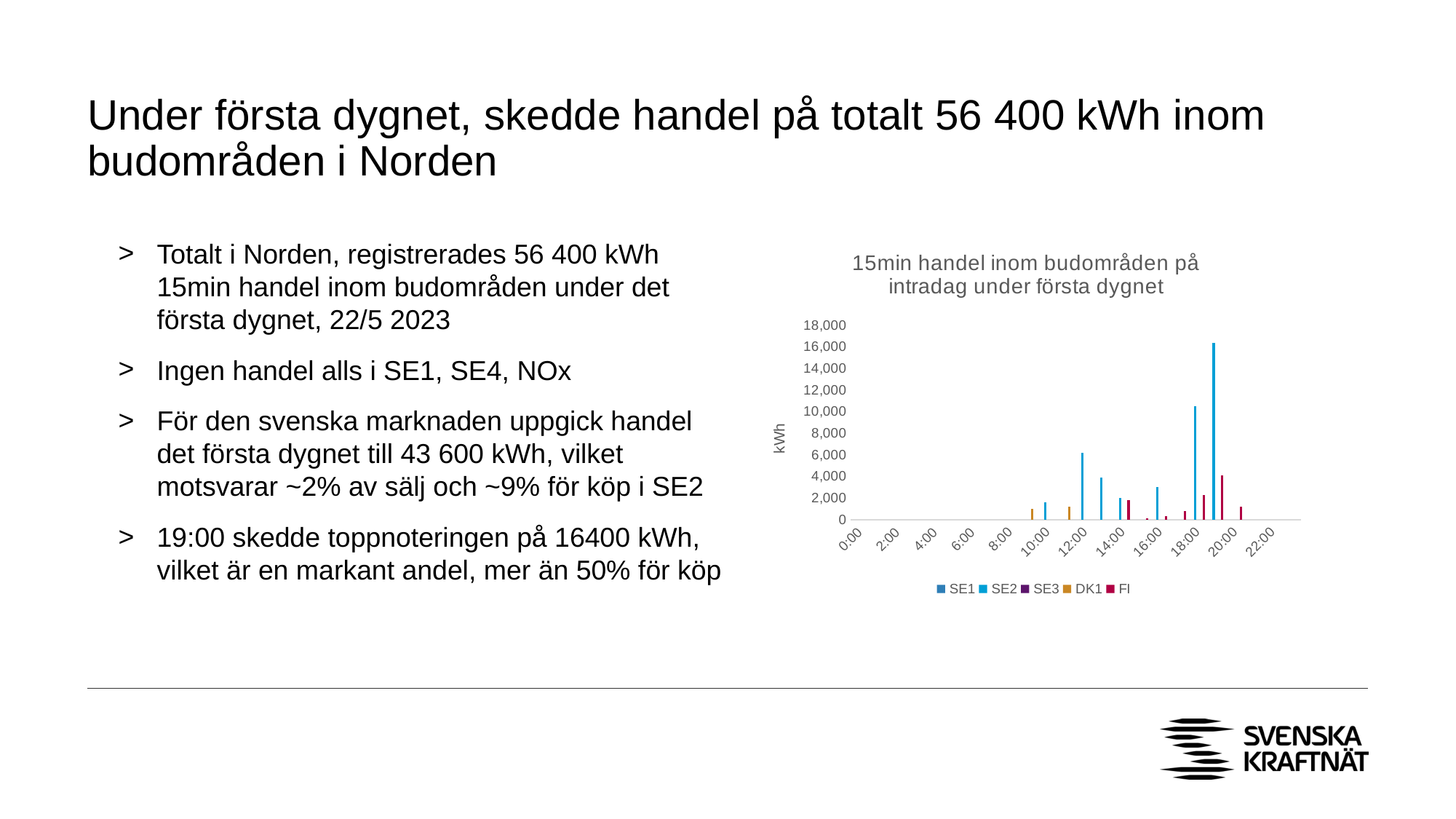
How many series does the chart legend list? 5 Which series has the tallest bar in the chart? SE2 What kind of chart is shown on the slide? bar chart What is the title of the chart? 15min handel inom budområden på intradag under första dygnet Which is larger, the tallest SE2 bar or the tallest FI bar? SE2 Is the tallest FI bar greater or less than 6,000? less Is the tallest SE2 bar (around 19:00) greater or less than 14,000? greater Which series are listed in the chart legend? SE1, SE2, SE3, DK1, FI Is the SE2 bar around 18:00 greater or less than 8,000? greater How many time labels are shown on the x axis of the chart? 12